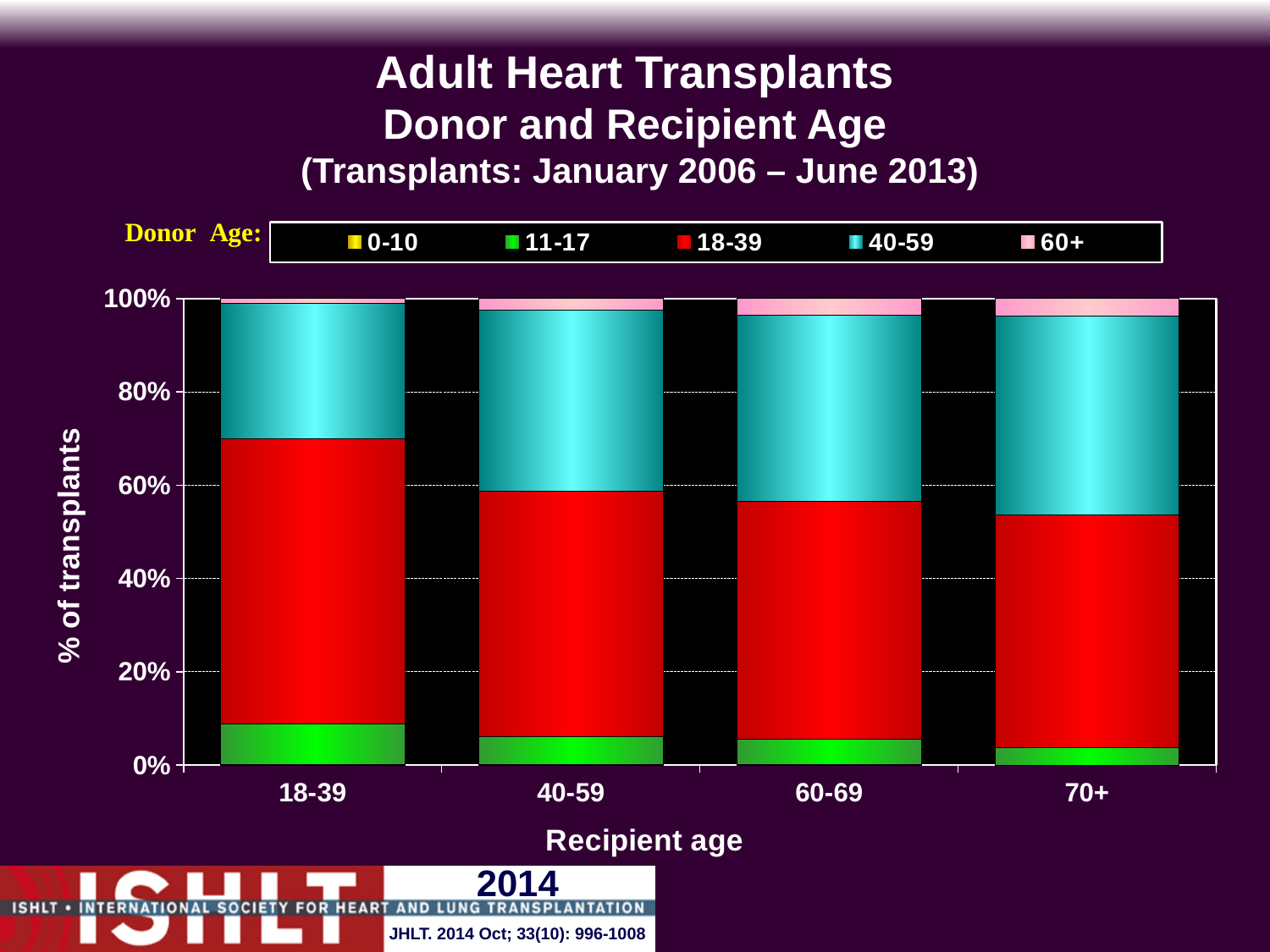
Which recipient age group has the largest share of transplants from 18-39 year old donors? 18-39 As recipient age increases along the x axis, does the share of transplants from 18-39 year old donors rise or fall? fall What is the label of the y axis? % of transplants Is the share of transplants from 11-17 year old donors larger for 18-39 recipients or for 70+ recipients? 18-39 What is the title of the chart? Adult Heart Transplants Donor and Recipient Age (Transplants: January 2006 – June 2013) What does each stacked bar total? 100% Which recipient age group has the smallest share of transplants from 11-17 year old donors? 70+ For 70+ recipients, does the top of the 18-39 donor segment lie greater or less than 60%? less For 18-39 recipients, does the top of the 18-39 donor segment lie greater or less than 60%? greater How many donor age groups does the legend list? 5 What kind of chart is shown on the slide? stacked bar chart How many recipient age categories are shown on the x axis? 4